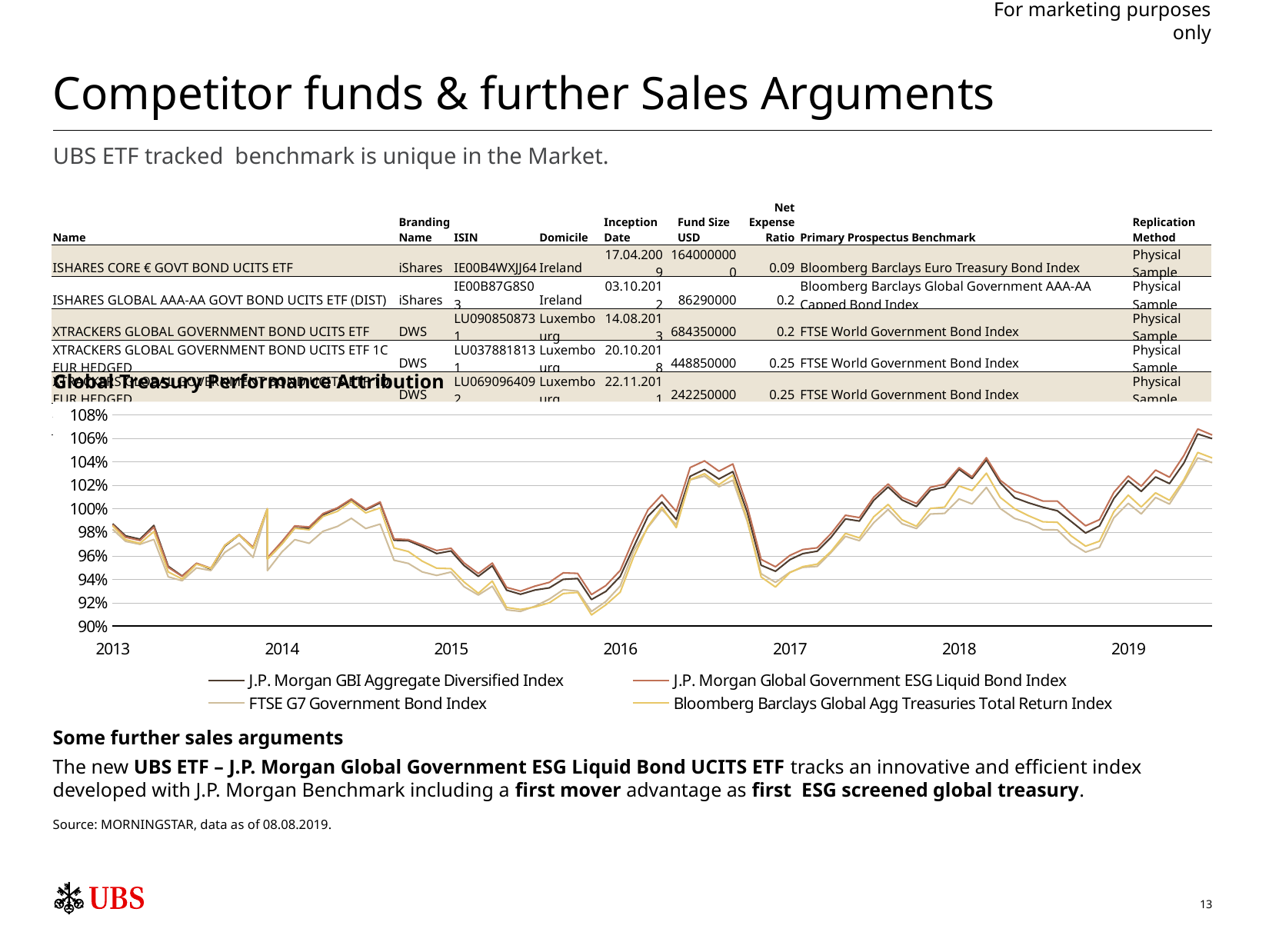
What is the title of the chart? Global Treasury Performance Attribution Is the value of the J.P. Morgan Global Government ESG Liquid Bond Index at the end of the chart (2019) greater or less than 104%? greater What is the highest value shown on the y axis of the chart? 108% At the end of the chart in 2019, which is higher: the J.P. Morgan Global Government ESG Liquid Bond Index or the FTSE G7 Government Bond Index? J.P. Morgan Global Government ESG Liquid Bond Index Which series is drawn in the darkest line in the chart legend? J.P. Morgan GBI Aggregate Diversified Index How many series does the chart legend list? 4 Overall, do the series values rise or fall from 2013 to 2019? rise How many year labels are shown on the x axis of the chart? 7 Is the value of the FTSE G7 Government Bond Index at its lowest point around the start of 2016 greater or less than 94%? less What kind of chart is shown on the slide? line chart What is the lowest value shown on the y axis of the chart? 90% Is the value of the J.P. Morgan GBI Aggregate Diversified Index at the start of 2013 greater or less than 96%? greater